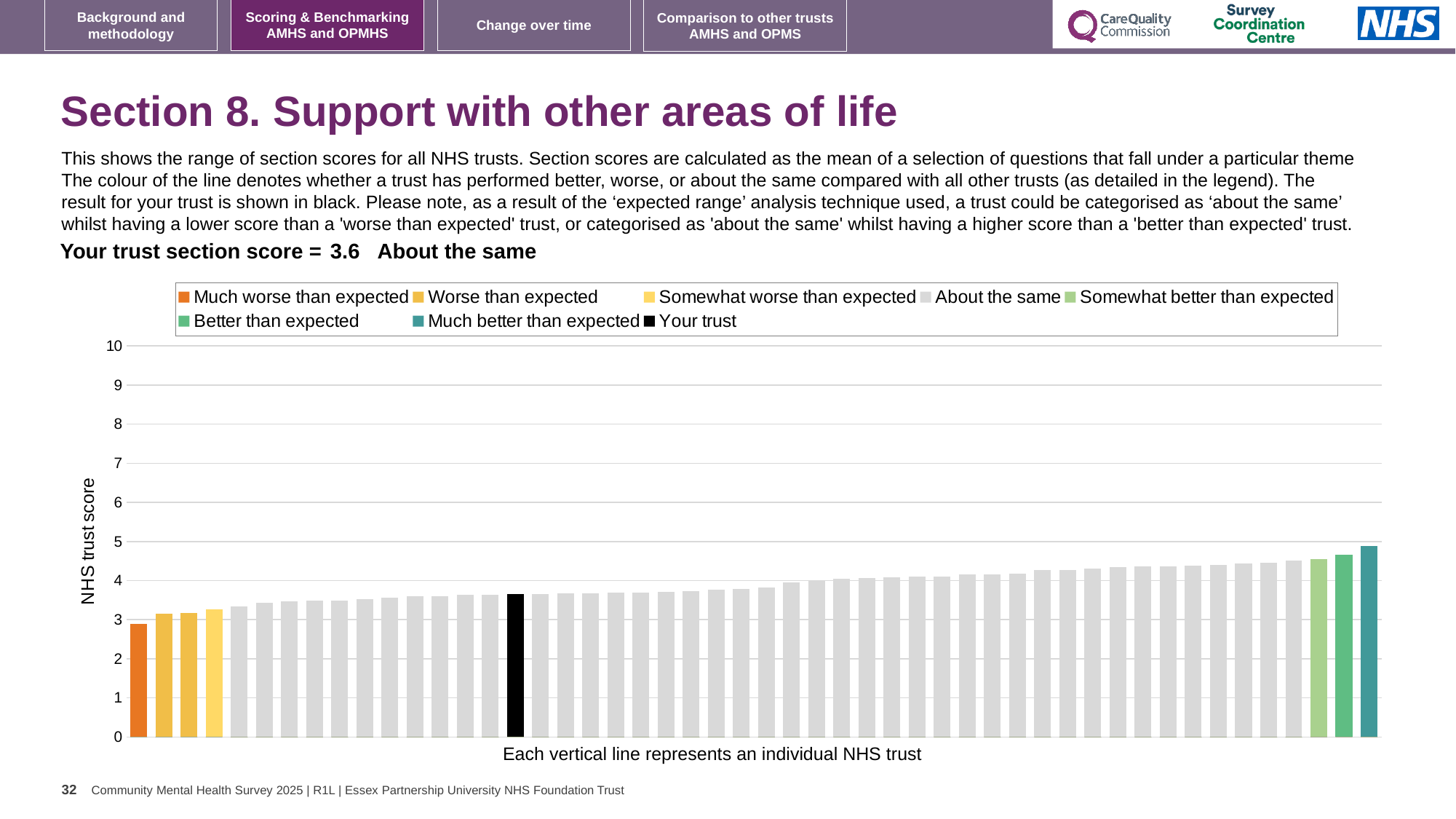
How many entries does the chart legend list? 8 Which legend category does the tallest bar belong to? Much better than expected Which legend category does the shortest bar belong to? Much worse than expected What kind of chart is shown on the slide? Bar chart Is the value of the black 'Your trust' bar greater or less than 3? greater Which category is your trust's section score placed in? About the same What is the section score for your trust? 3.6 What colour is used for the 'Your trust' bar in the legend? Black What is the label on the vertical axis of the chart? NHS trust score Is the value of the leftmost (orange) bar greater or less than 2? greater Is the value of the black 'Your trust' bar greater or less than 4? less Do the bar values rise or fall from left to right along the x axis? Rise